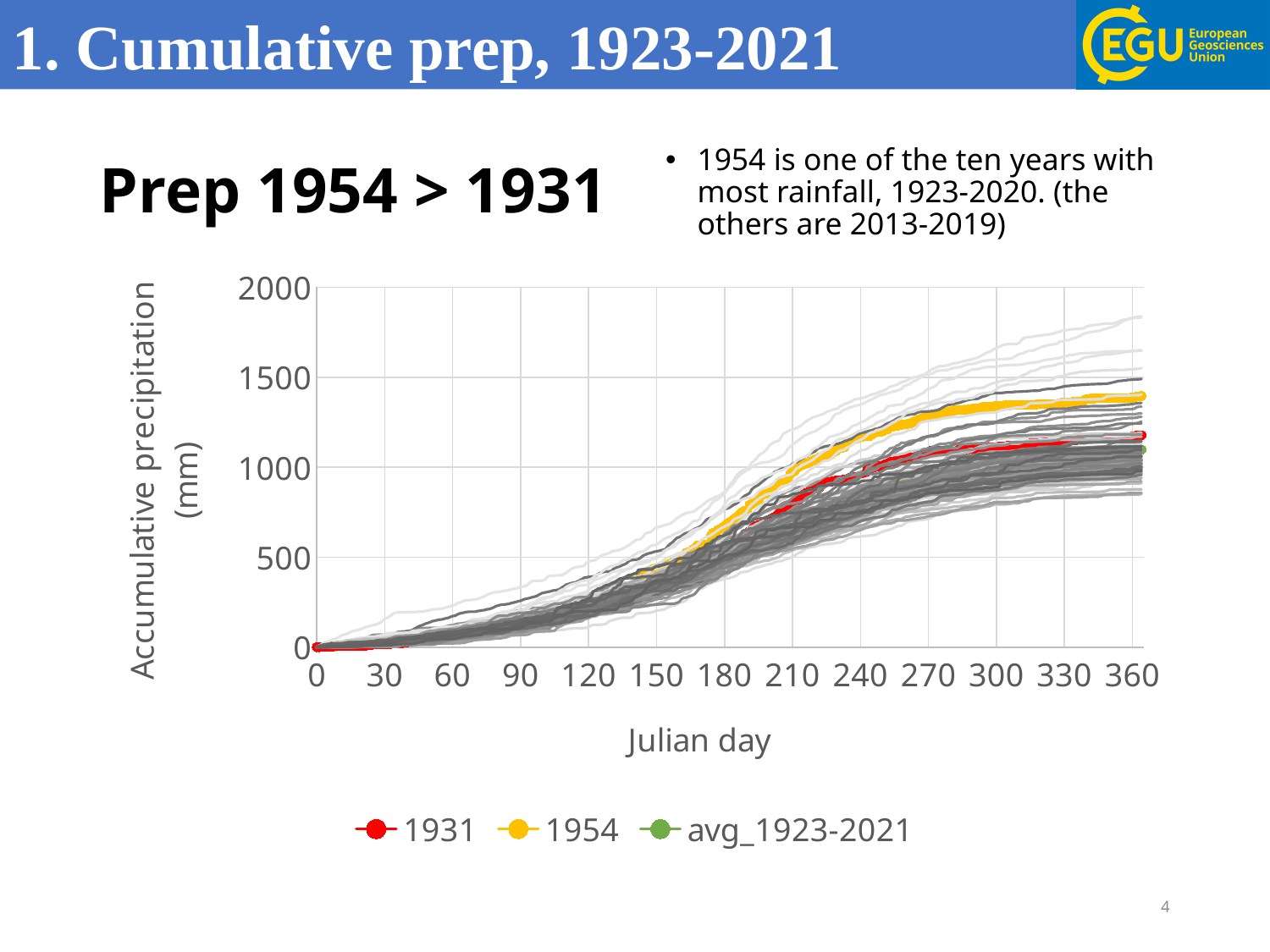
What kind of chart is shown on the slide? line chart What is the label of the y axis of the chart? Accumulative precipitation (mm) Is the value for the 1931 series at Julian day 360 greater or less than 1500? less How many series does the chart legend list? 3 Is the value for the 1954 series at Julian day 360 greater or less than 1500? less Is the value for the 1954 series at Julian day 360 greater or less than 1000? greater At Julian day 360, which series has the larger value, 1954 or 1931? 1954 What is the label of the x axis of the chart? Julian day Which series is drawn in yellow in the chart? 1954 Do the cumulative precipitation lines rise or fall as Julian day increases? rise